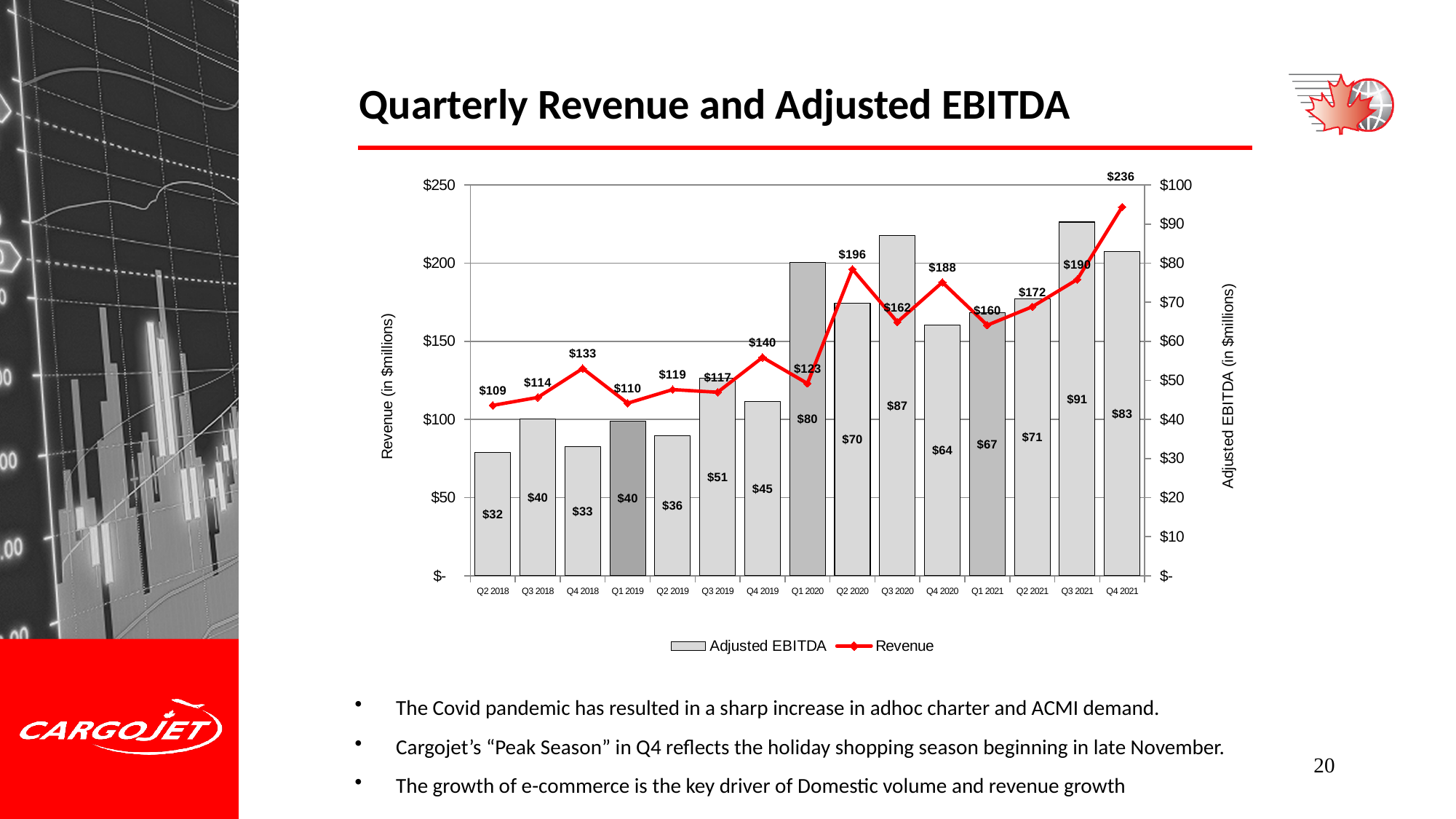
What is the difference in Revenue between Q4 2021 and Q3 2021? $46 What is the Revenue for Q1 2019? $110 What is the Adjusted EBITDA for Q3 2020? $87 How many quarters are shown on the x axis? 15 Which quarter has the highest Adjusted EBITDA? Q3 2021 Does Revenue rise or fall from Q1 2021 to Q4 2021? Rise Which quarter has the lowest Revenue? Q2 2018 Which is larger, the Adjusted EBITDA for Q1 2020 or for Q2 2020? Q1 2020 What is the title of the chart? Quarterly Revenue and Adjusted EBITDA What is the Revenue for Q4 2021? $236 What kind of chart is used to show Adjusted EBITDA? Bar chart How many series does the legend list? 2